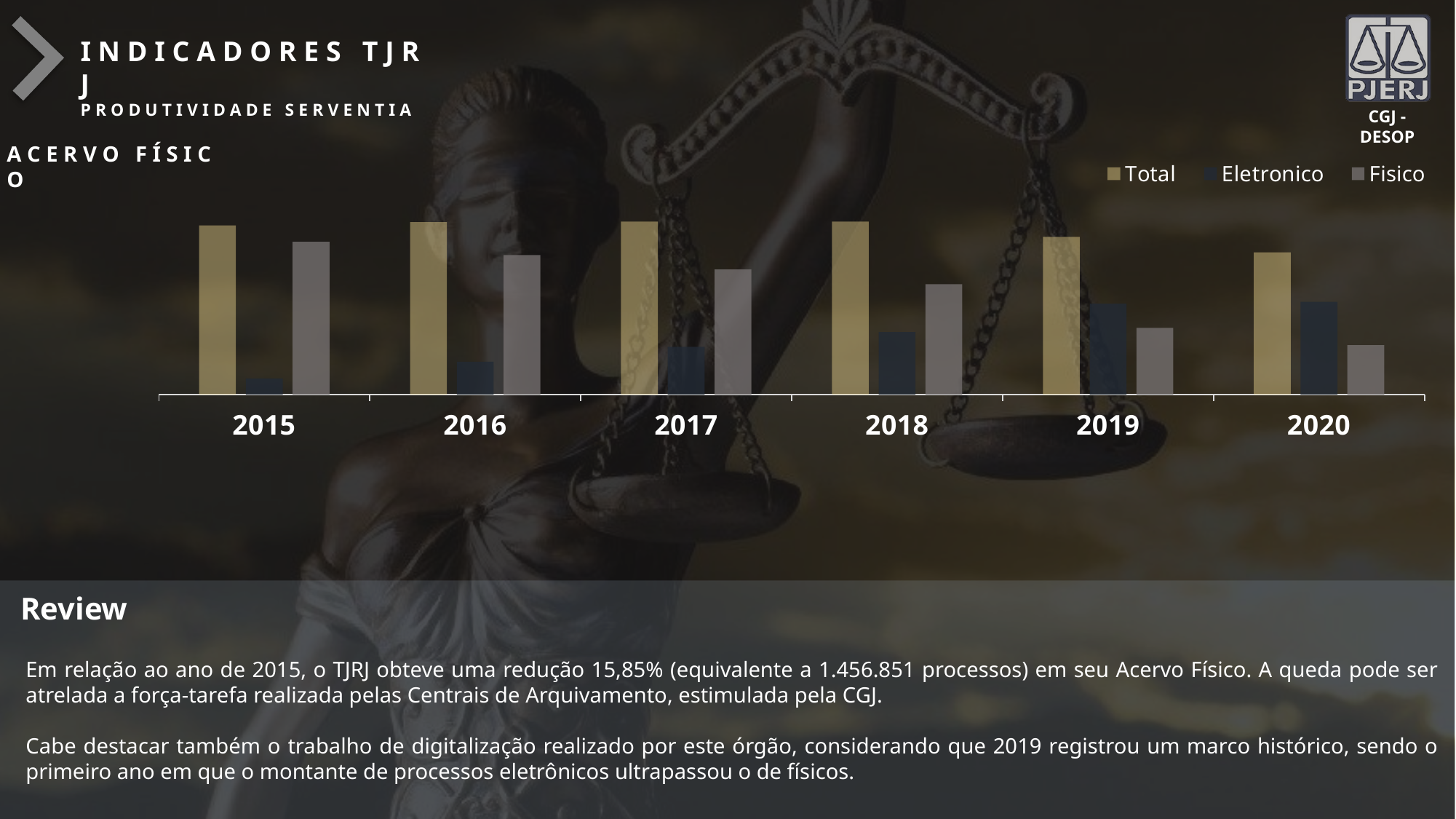
Do the Eletronico values rise or fall from 2015 to 2020? rise What are the three series named in the chart legend? Total, Eletronico, Fisico In which year is the Eletronico bar the lowest? 2015 Do the Fisico values rise or fall from 2015 to 2020? fall How many series does the chart legend list? 3 In which year is the Eletronico bar the highest? 2020 In which year is the Fisico bar the lowest? 2020 In 2015, which is larger, the Eletronico bar or the Fisico bar? Fisico Which series is drawn in gold/yellow bars? Total What kind of chart is shown on the slide? bar chart How many years are shown on the x axis of the chart? 6 In which year is the Total bar the lowest? 2020